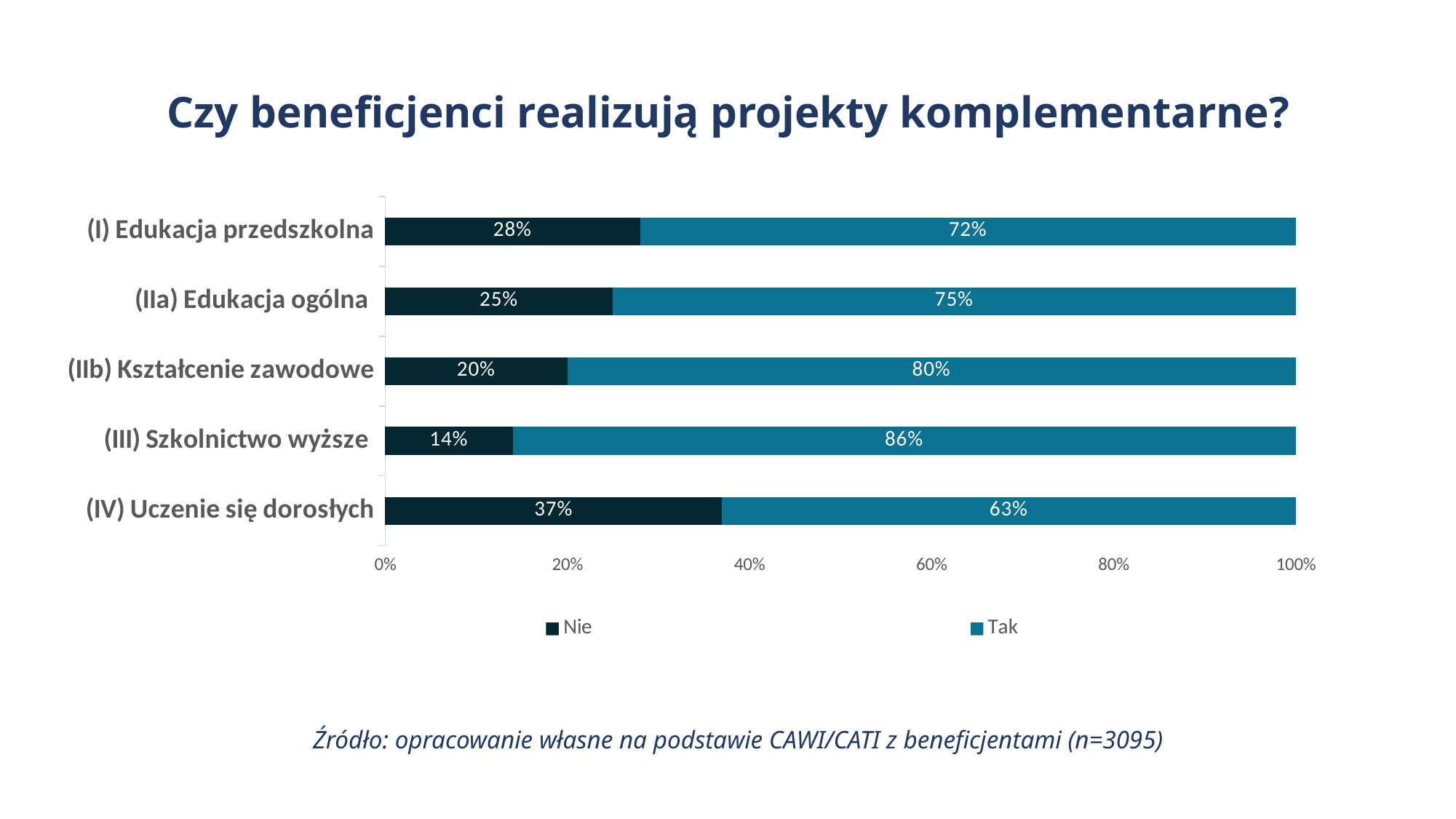
Which category has the lowest "Nie" value? (III) Szkolnictwo wyższe Is the "Tak" value for (IV) Uczenie się dorosłych greater or less than 60%? greater How many series does the legend list? 2 What is the "Tak" value for (IIb) Kształcenie zawodowe? 80% What is the "Nie" value for (IV) Uczenie się dorosłych? 37% Which is larger: the "Nie" value for (I) Edukacja przedszkolna or for (IIb) Kształcenie zawodowe? (I) Edukacja przedszkolna What is the difference between the "Tak" values for (IIa) Edukacja ogólna and (IV) Uczenie się dorosłych? 12 percentage points Which category has the highest "Tak" value? (III) Szkolnictwo wyższe What are the two legend entries of the chart? Nie and Tak What kind of chart is shown on the slide? Stacked bar chart What is the "Tak" value for (III) Szkolnictwo wyższe? 86% How many categories are shown on the chart? 5